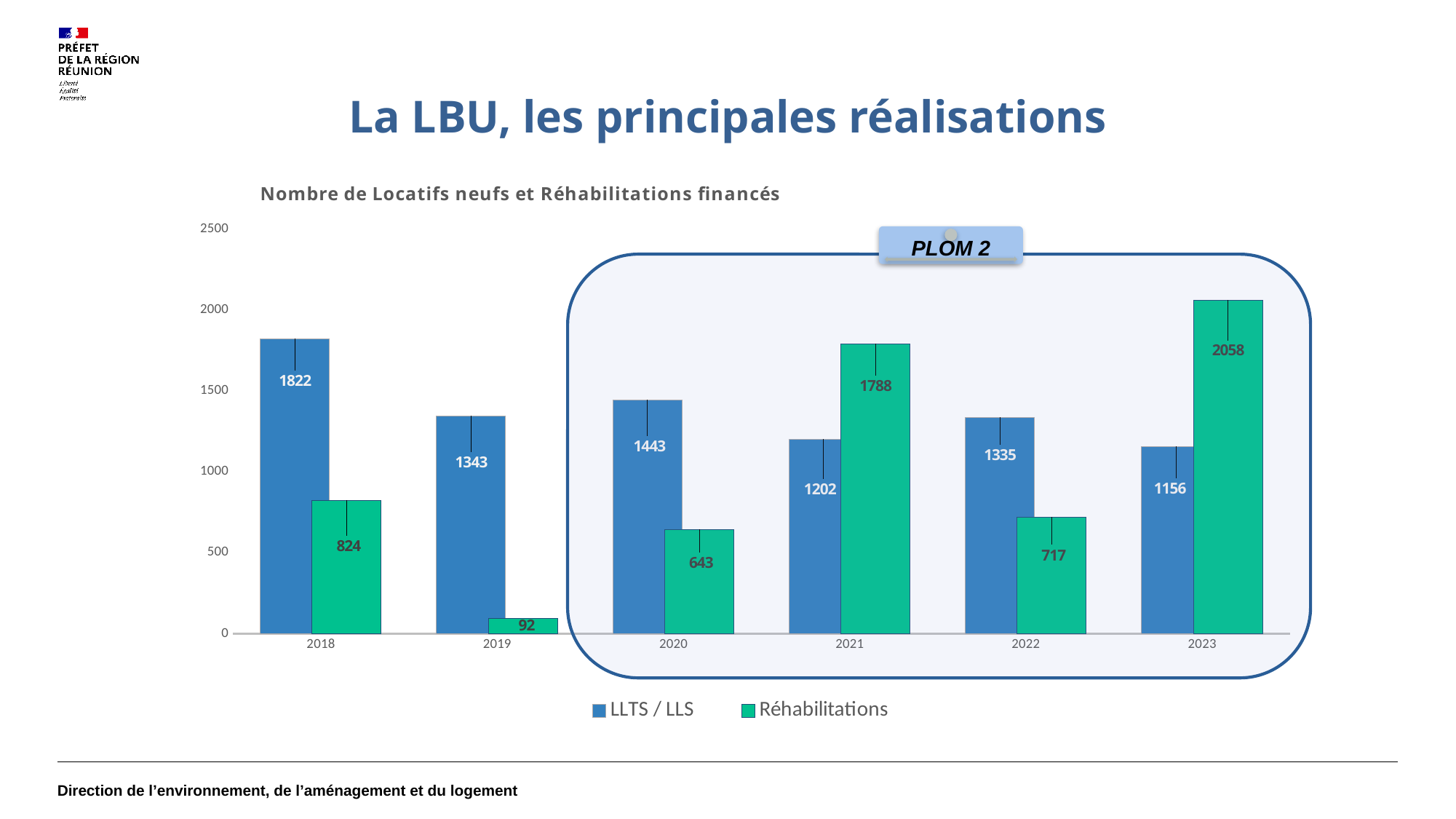
What is the difference between LLTS / LLS and Réhabilitations in 2021? 586 What is the value for LLTS / LLS in 2018? 1822 Which year has the lowest value for LLTS / LLS? 2023 What is the title of the chart? Nombre de Locatifs neufs et Réhabilitations financés What kind of chart is shown? bar chart Which is larger in 2022, LLTS / LLS or Réhabilitations? LLTS / LLS What is the value for Réhabilitations in 2019? 92 How many years are shown on the x axis? 6 What is the value for Réhabilitations in 2023? 2058 Is the value for Réhabilitations in 2020 greater or less than 500? greater Which year has the highest value for Réhabilitations? 2023 How many series does the legend list? 2